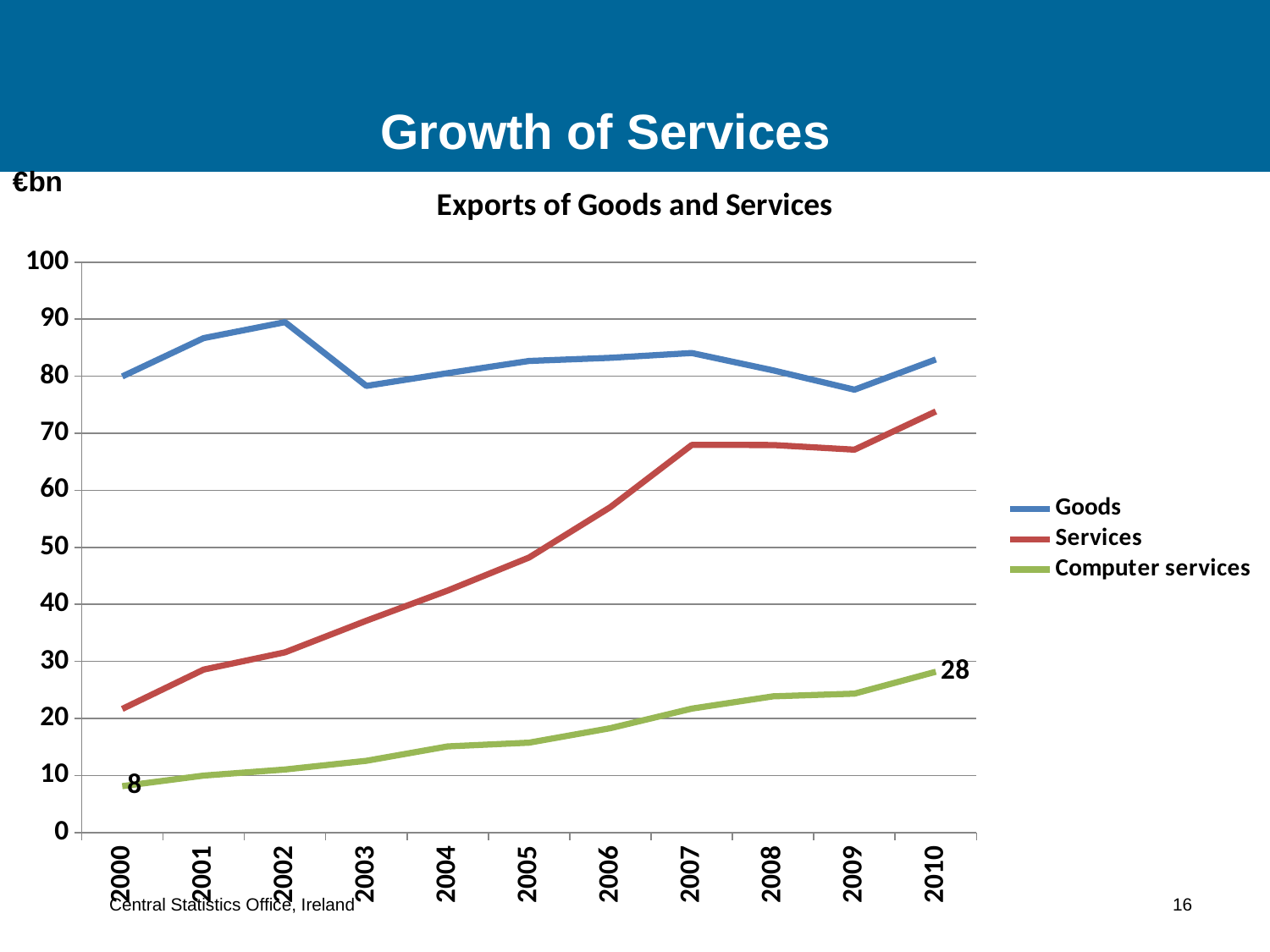
What type of chart is shown on the slide? line chart In which year is the Services value lowest? 2000 What is the value for Computer services in 2000? 8 How many series does the legend list? 3 By how much did Computer services exports increase from 2000 to 2010? 20 Is the value for Services in 2004 greater or less than 50? less Do the values for Services generally rise or fall from 2000 to 2010? rise What is the value for Computer services in 2010? 28 What is the title of the chart? Exports of Goods and Services Is the value for Services in 2010 greater or less than 70? greater In 2010, which is larger: Goods or Services? Goods How many years are plotted along the x axis? 11